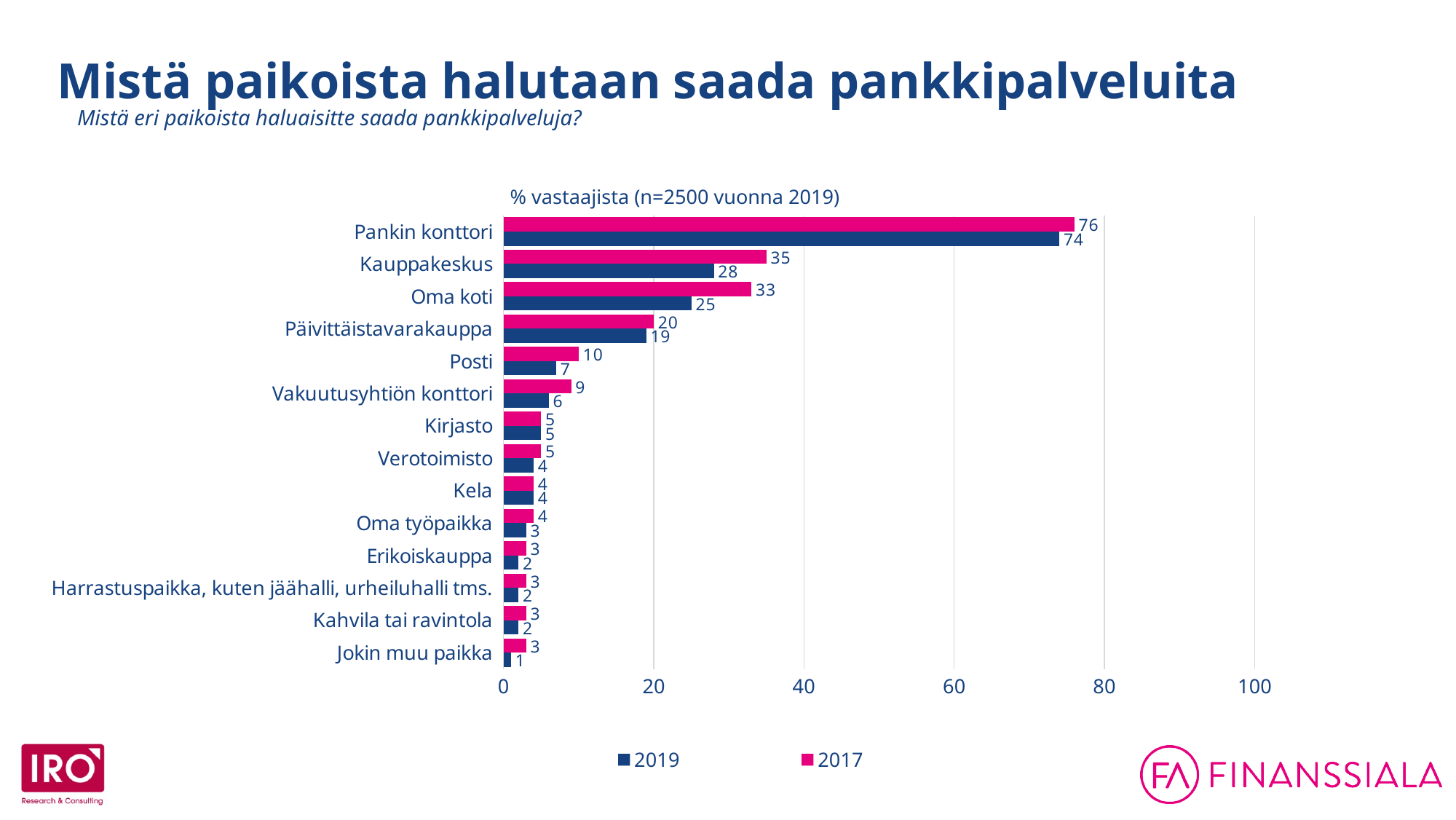
What is the 2019 value for Pankin konttori? 74 What is the difference between the 2017 and 2019 values for Kauppakeskus? 7 What kind of chart is shown on the slide? Bar chart What is the 2017 value for Posti? 10 Which colour represents the 2017 series? Pink Which is larger for Päivittäistavarakauppa, the 2017 value or the 2019 value? 2017 How many series does the legend list? 2 What is the 2019 value for Oma koti? 25 Which category has the highest 2019 value? Pankin konttori What is the 2017 value for Kauppakeskus? 35 How many categories are shown on the chart? 14 Which category has the lowest 2019 value? Jokin muu paikka